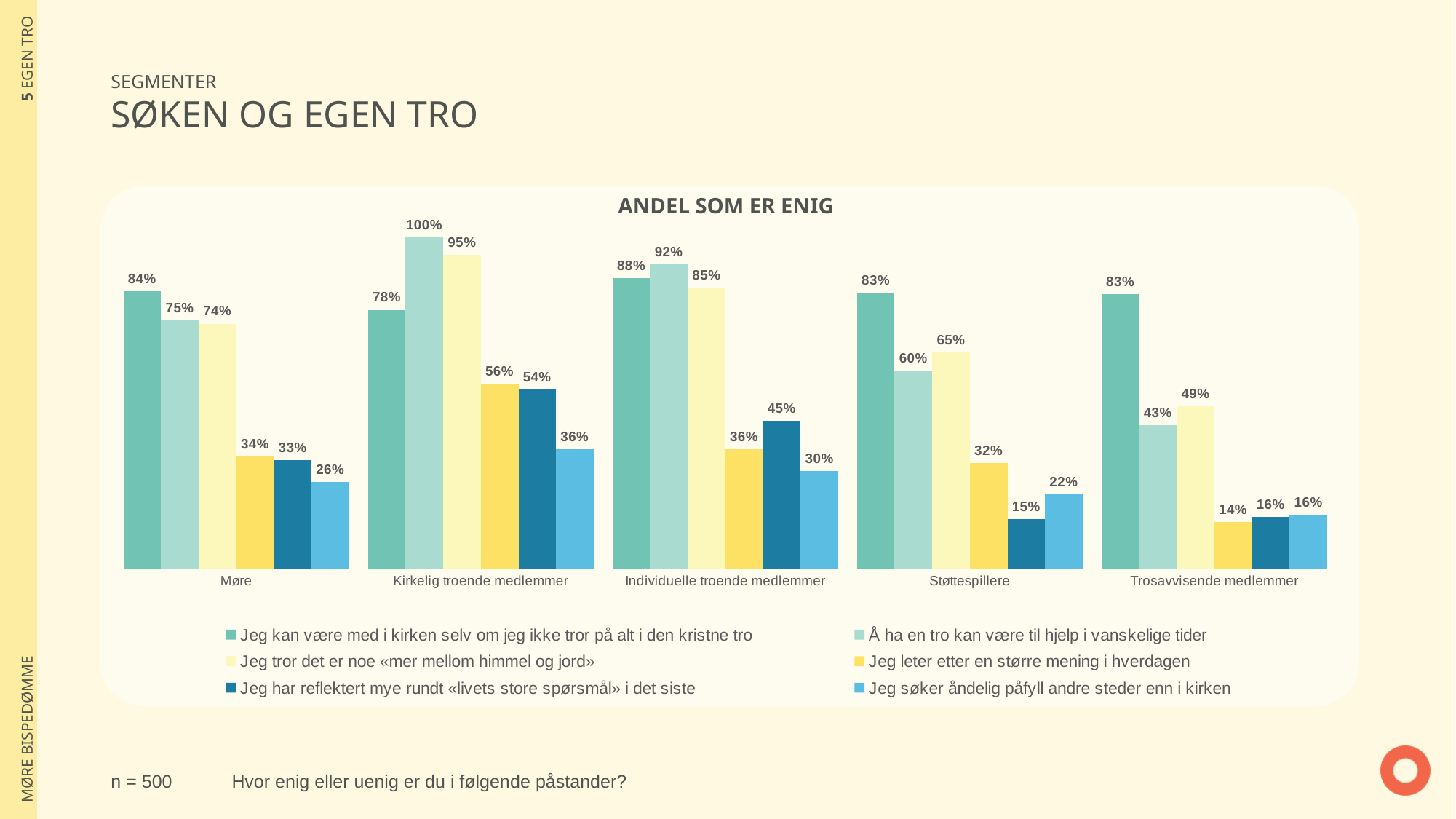
How many categories are shown on the x axis of the chart? 5 What is the difference between the values for "Jeg kan være med i kirken selv om jeg ikke tror på alt i den kristne tro" and "Jeg søker åndelig påfyll andre steder enn i kirken" in the Støttespillere group? 61 percentage points What is the title of the chart? ANDEL SOM ER ENIG What is the sample size (n) stated on the slide? n = 500 What kind of chart is shown on the slide? Bar chart What is the value for "Å ha en tro kan være til hjelp i vanskelige tider" in the Kirkelig troende medlemmer group? 100% Which category has the highest value for "Jeg leter etter en større mening i hverdagen"? Kirkelig troende medlemmer How many series does the legend list? 6 What is the value for "Jeg søker åndelig påfyll andre steder enn i kirken" in the Møre group? 26% In the Trosavvisende medlemmer group, which is larger: "Å ha en tro kan være til hjelp i vanskelige tider" or "Jeg tror det er noe «mer mellom himmel og jord»"? Jeg tror det er noe «mer mellom himmel og jord» Which category has the lowest value for "Å ha en tro kan være til hjelp i vanskelige tider"? Trosavvisende medlemmer What is the value for "Jeg har reflektert mye rundt «livets store spørsmål» i det siste" in the Individuelle troende medlemmer group? 45%